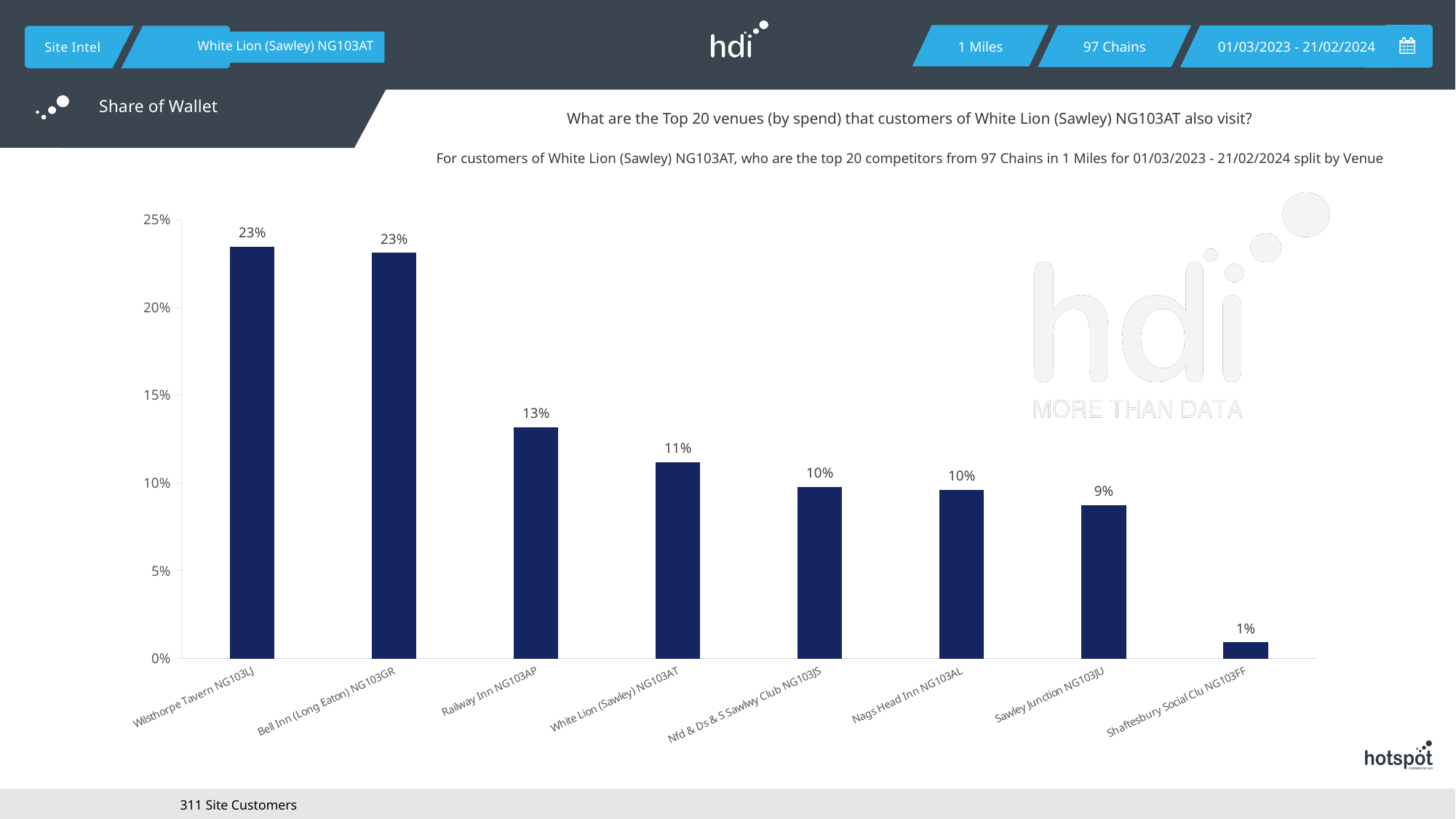
What is the difference between the values for Railway Inn NG103AP and White Lion (Sawley) NG103AT? 2% Which venue has the lowest value? Shaftesbury Social Clu NG103FF What is the value for Wilsthorpe Tavern NG103LJ? 23% Do the values rise or fall from left to right along the x axis? fall What is the value for White Lion (Sawley) NG103AT? 11% What is the value for Sawley Junction NG103JU? 9% Which is larger, the value for Railway Inn NG103AP or the value for Sawley Junction NG103JU? Railway Inn NG103AP Is the value for Nags Head Inn NG103AL greater or less than 15%? less What kind of chart is shown on the slide? bar chart What is the value for Railway Inn NG103AP? 13% How many venues are shown on the chart? 8 What is the difference between the values for Bell Inn (Long Eaton) NG103GR and Shaftesbury Social Clu NG103FF? 22%